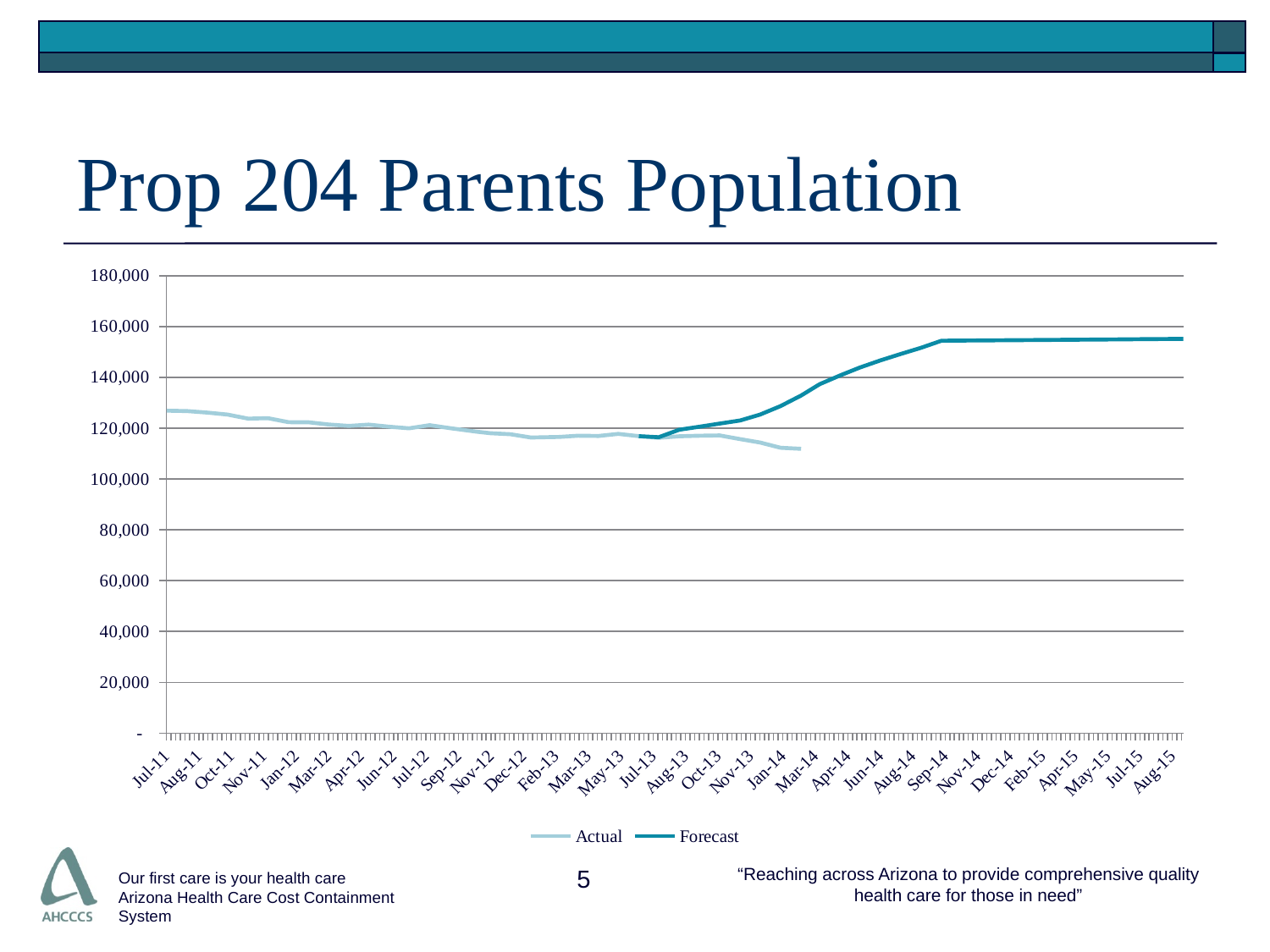
What are the two series named in the legend? Actual and Forecast Is the Forecast value for Aug-15 greater or less than 140,000? greater What is the title of the slide containing the chart? Prop 204 Parents Population Which is larger: the Forecast value for Aug-15 or the Actual value for Jul-11? Forecast value for Aug-15 Is the Forecast value for Aug-15 greater or less than 160,000? less Is the Forecast value for Mar-14 greater or less than 120,000? greater What kind of chart is shown on the slide? Line chart Does the Actual series generally rise or fall from Jul-11 to its last plotted point? Fall Does the Forecast series rise or fall between Jul-13 and Sep-14? Rise How many series does the legend list? 2